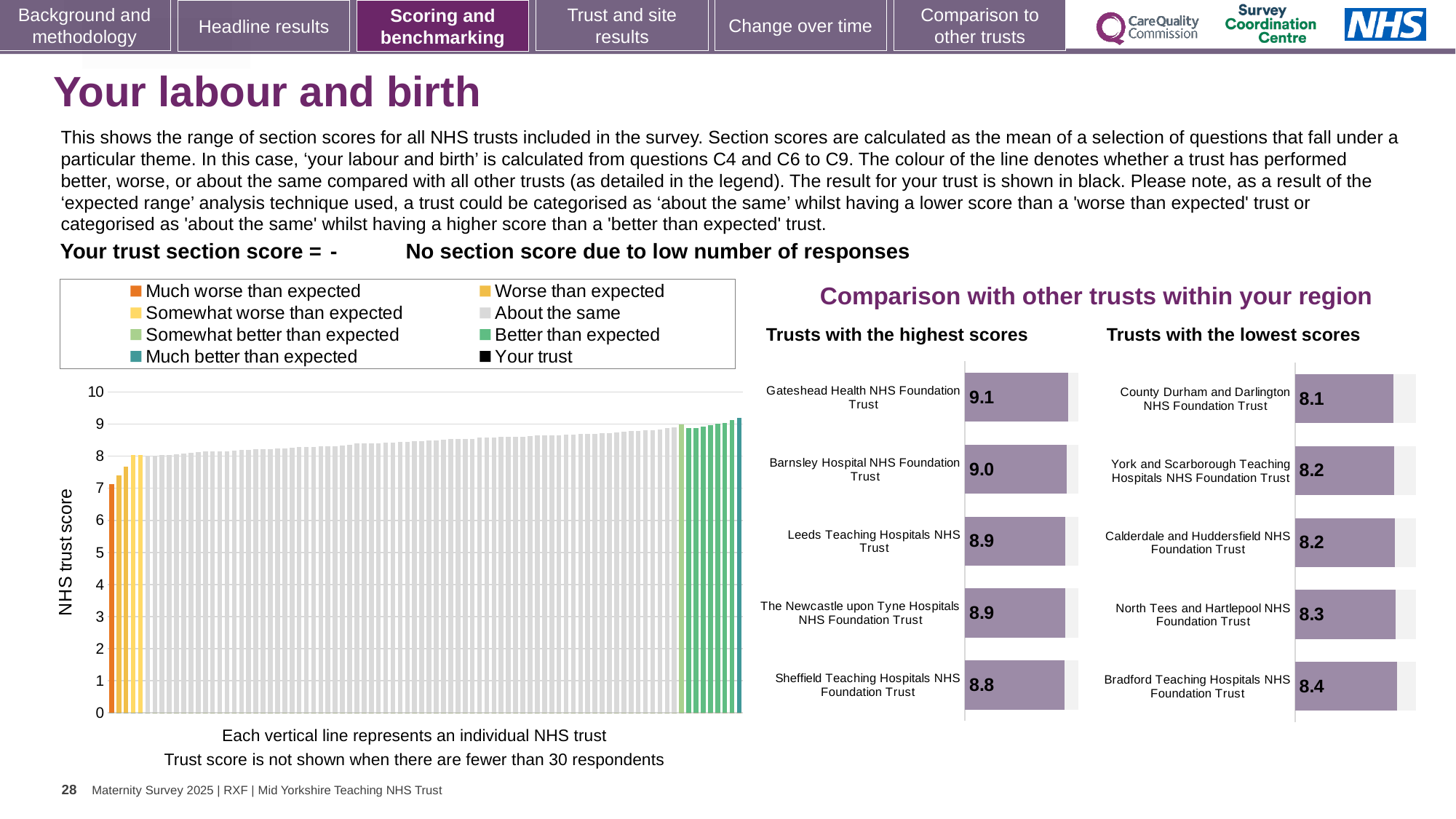
How many entries does the legend of the main 'NHS trust score' chart list? 8 In the 'Trusts with the highest scores' chart, what is the score for Sheffield Teaching Hospitals NHS Foundation Trust? 8.8 In the main 'NHS trust score' chart, is the value of the tallest bar greater or less than 9? greater In the 'Trusts with the lowest scores' chart, what is the score for Bradford Teaching Hospitals NHS Foundation Trust? 8.4 In the 'Trusts with the lowest scores' chart, what is the score for County Durham and Darlington NHS Foundation Trust? 8.1 In the 'Trusts with the highest scores' chart, what is the score for Gateshead Health NHS Foundation Trust? 9.1 In the 'Trusts with the highest scores' chart, what is the difference between the scores of Gateshead Health NHS Foundation Trust and Sheffield Teaching Hospitals NHS Foundation Trust? 0.3 Comparing the two small charts on the right, which has the higher score: Barnsley Hospital NHS Foundation Trust or North Tees and Hartlepool NHS Foundation Trust? Barnsley Hospital NHS Foundation Trust What kind of chart is the main 'NHS trust score' chart on the left? bar chart How many trusts are shown in the 'Trusts with the highest scores' chart? 5 In the 'Trusts with the lowest scores' chart, which trust has the lowest score? County Durham and Darlington NHS Foundation Trust In the 'Trusts with the highest scores' chart, which trust has the highest score? Gateshead Health NHS Foundation Trust